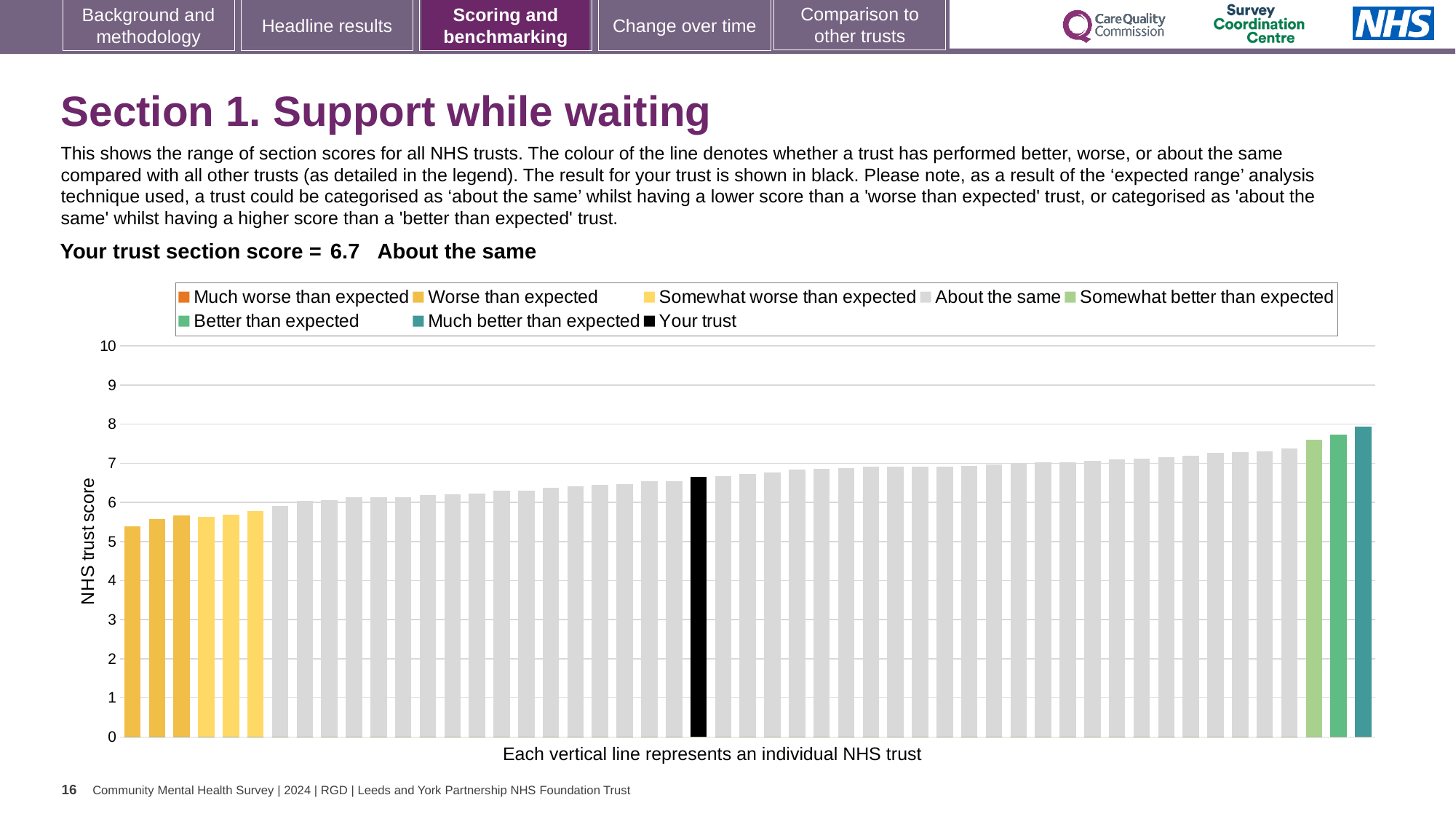
What colour is the bar representing your trust? black What is the label on the vertical axis of the chart? NHS trust score What is the section score for your trust shown on the slide? 6.7 How many bars are coloured teal (much better than expected)? 1 What kind of chart is shown on the slide? bar chart Do the bar values rise or fall from left to right along the x axis? rise Which is larger, the leftmost bar or the rightmost bar? the rightmost bar Is the value of the shortest bar (leftmost) greater or less than 5? greater Is the value of the black bar (your trust) greater or less than 6? greater How many entries does the chart legend list? 8 Which performance category is your trust placed in for this section? About the same